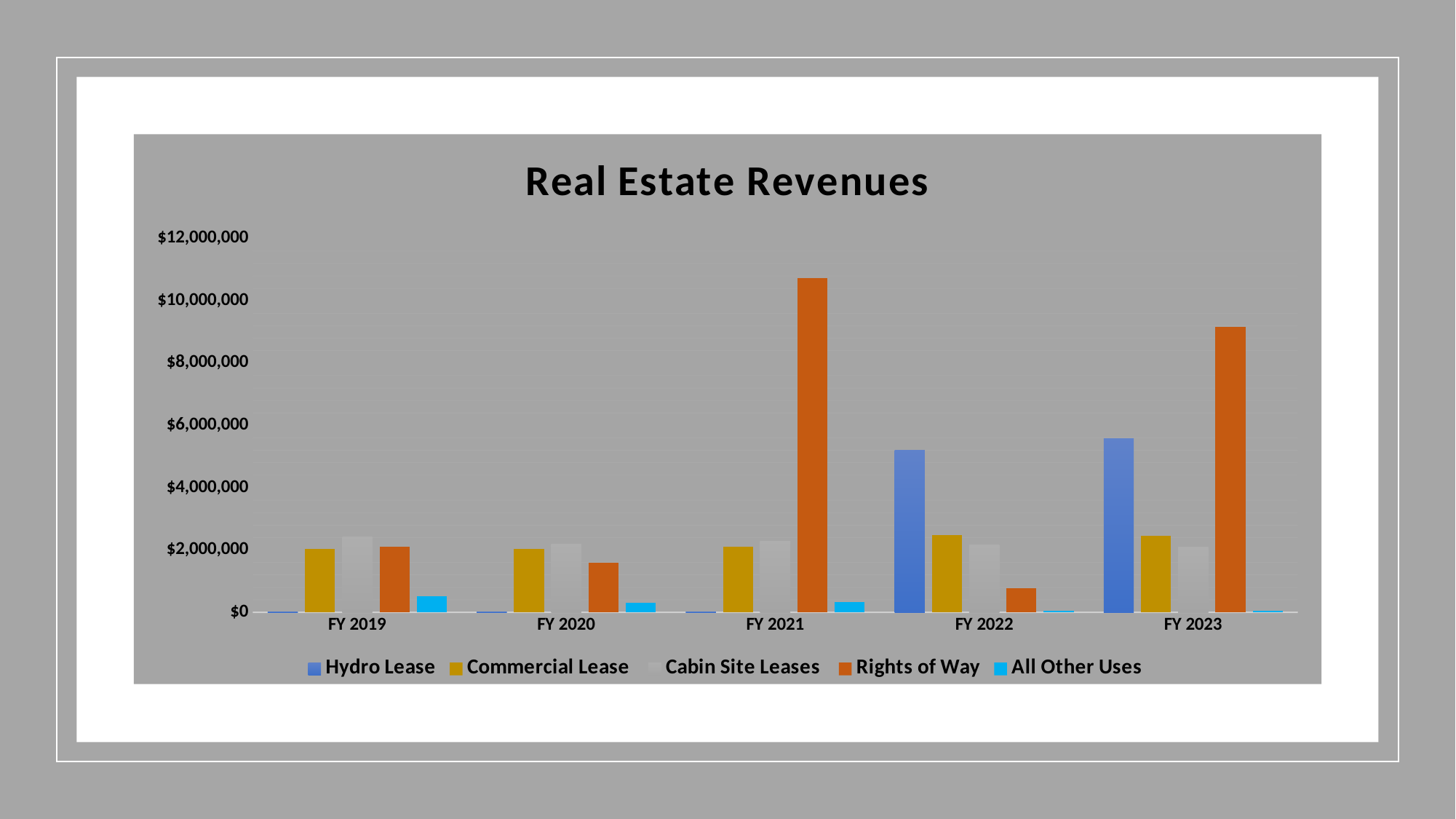
How many fiscal years are shown on the x axis? 5 What kind of chart is shown on the slide? bar chart Is the Rights of Way value for FY 2023 greater or less than $8,000,000? greater Is the Rights of Way value for FY 2021 greater or less than $10,000,000? greater Is the Hydro Lease value for FY 2022 greater or less than $4,000,000? greater Which series has the highest value in FY 2021? Rights of Way Which is larger, the Rights of Way value for FY 2021 or for FY 2023? FY 2021 In which fiscal year is the Rights of Way revenue lowest? FY 2022 What is the title of the chart? Real Estate Revenues In which fiscal year is the Rights of Way revenue highest? FY 2021 How many series does the legend list? 5